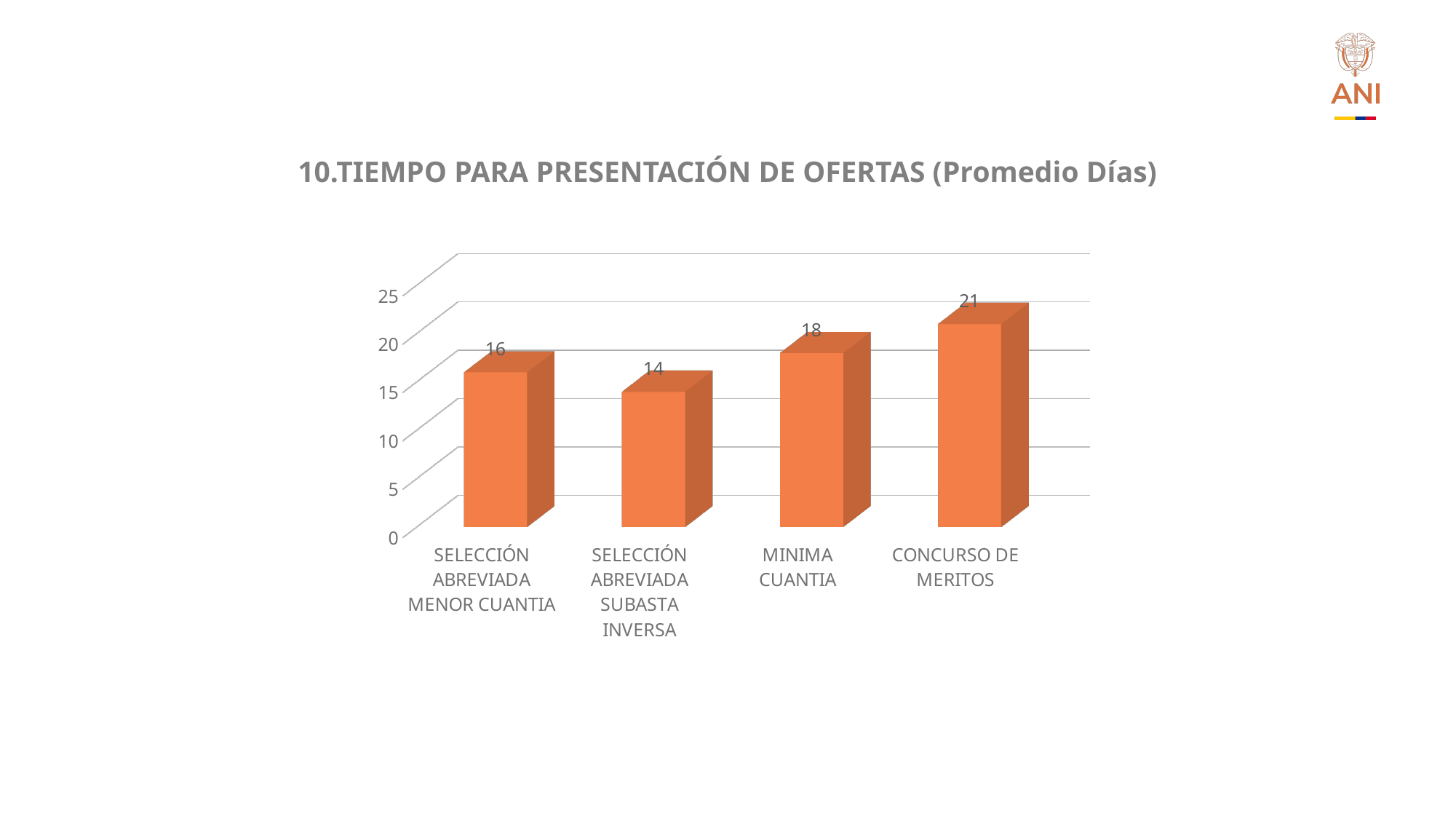
How many categories are shown in the chart? 4 Which is larger, the value for MINIMA CUANTIA or the value for SELECCIÓN ABREVIADA MENOR CUANTIA? MINIMA CUANTIA What is the value for MINIMA CUANTIA? 18 What is the value for SELECCIÓN ABREVIADA MENOR CUANTIA? 16 What is the title of the chart? 10.TIEMPO PARA PRESENTACIÓN DE OFERTAS (Promedio Días) Which category has the lowest value? SELECCIÓN ABREVIADA SUBASTA INVERSA Which category has the highest value? CONCURSO DE MERITOS What kind of chart is shown on the slide? bar chart What is the difference between the values for CONCURSO DE MERITOS and SELECCIÓN ABREVIADA SUBASTA INVERSA? 7 What is the value for CONCURSO DE MERITOS? 21 Is the value for CONCURSO DE MERITOS greater or less than 20? greater What is the value for SELECCIÓN ABREVIADA SUBASTA INVERSA? 14